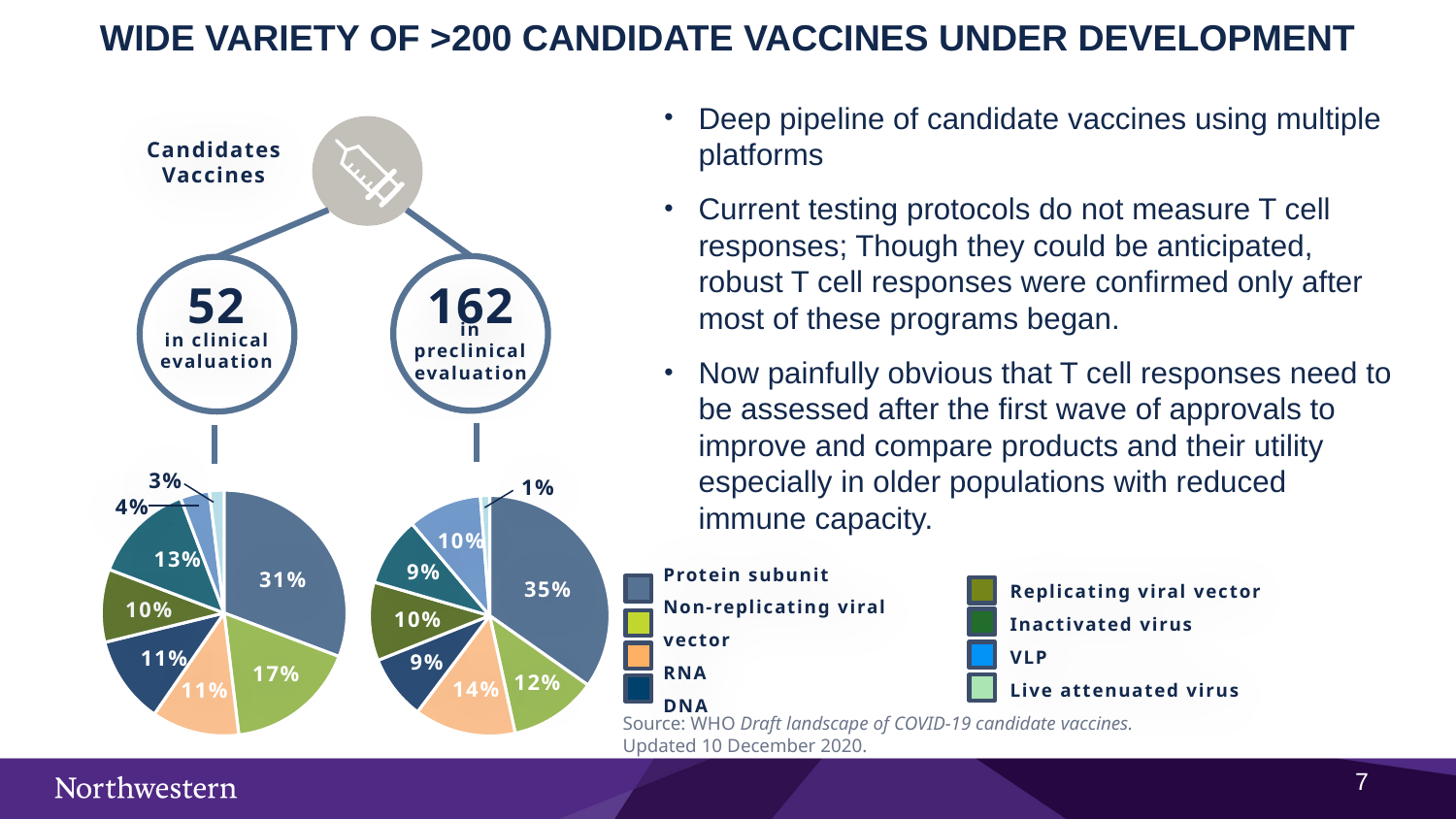
How many vaccine platform categories does the legend list? 8 How many slices does the pie chart for candidates in preclinical evaluation have? 8 How many candidate vaccines are in clinical evaluation according to the slide? 52 In the pie chart for candidates in preclinical evaluation, what share do RNA vaccines make up? 14% In the pie chart for candidates in clinical evaluation, what share do Non-replicating viral vector vaccines make up? 17% In the pie chart for candidates in clinical evaluation, what is the smallest slice's share? 3% In the pie chart for candidates in clinical evaluation, what share do Protein subunit vaccines make up? 31% What is the difference between the largest slice in the preclinical evaluation pie chart (35%) and the largest slice in the clinical evaluation pie chart (31%)? 4% In the pie chart for candidates in preclinical evaluation, what is the largest slice's share? 35% What kind of charts are shown on the slide? Pie charts In the pie chart for candidates in preclinical evaluation, what is the smallest slice's share? 1% In the pie chart for candidates in clinical evaluation, what is the largest slice's share? 31%